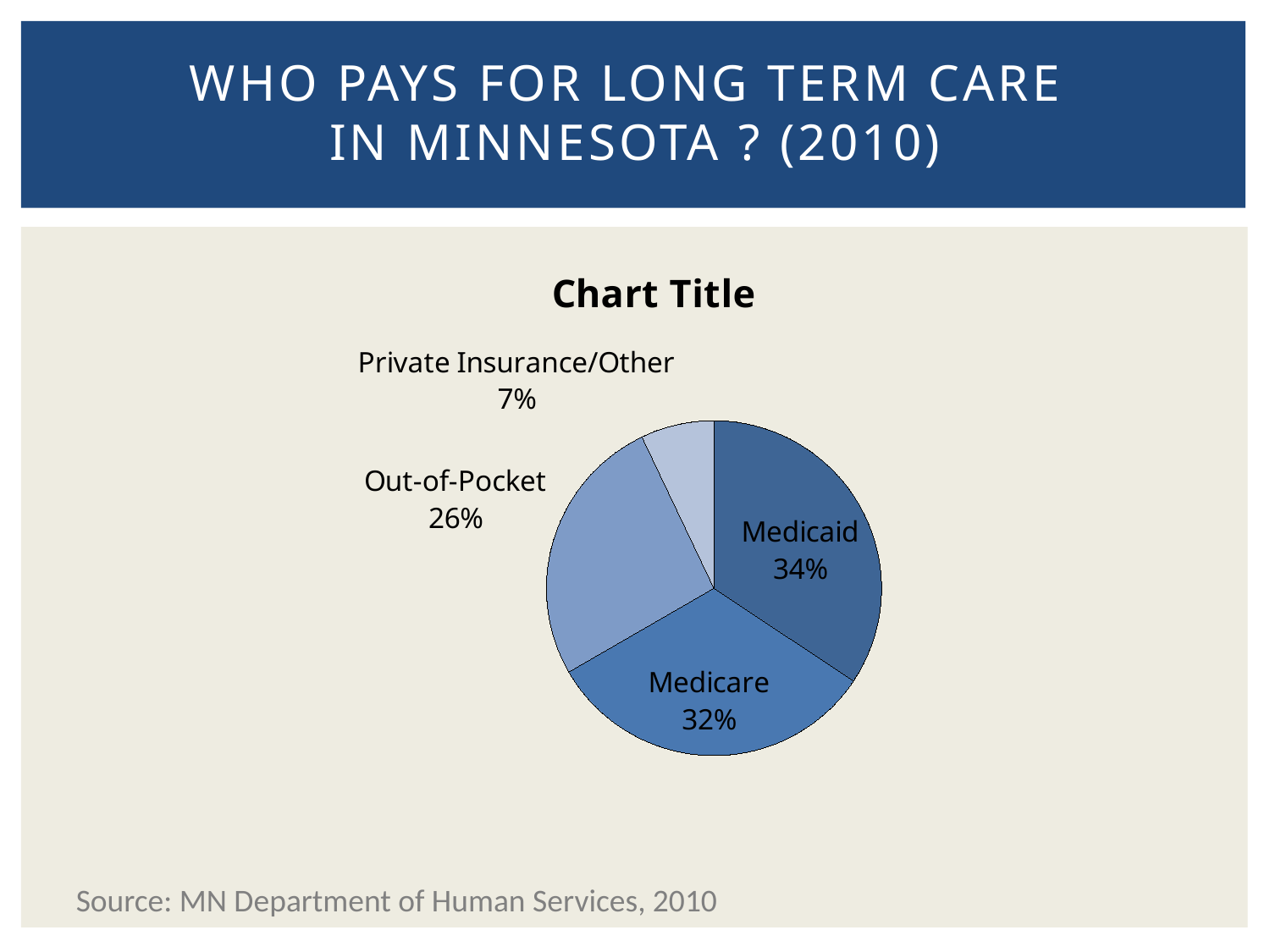
What percentage is shown for Out-of-Pocket? 26% Which is larger, the Medicare share or the Out-of-Pocket share? Medicare Which payer has the largest slice of the pie? Medicaid What is the difference in percentage points between Out-of-Pocket and Private Insurance/Other? 19 What kind of chart is shown on the slide? pie chart How many slices does the pie chart have? 4 What share of long term care payment does Medicaid account for? 34% Which payer has the smallest slice of the pie? Private Insurance/Other What percentage is shown for Medicare? 32% What is the difference in percentage points between Medicaid and Out-of-Pocket? 8 What is the title printed above the pie chart? Chart Title What percentage is shown for Private Insurance/Other? 7%